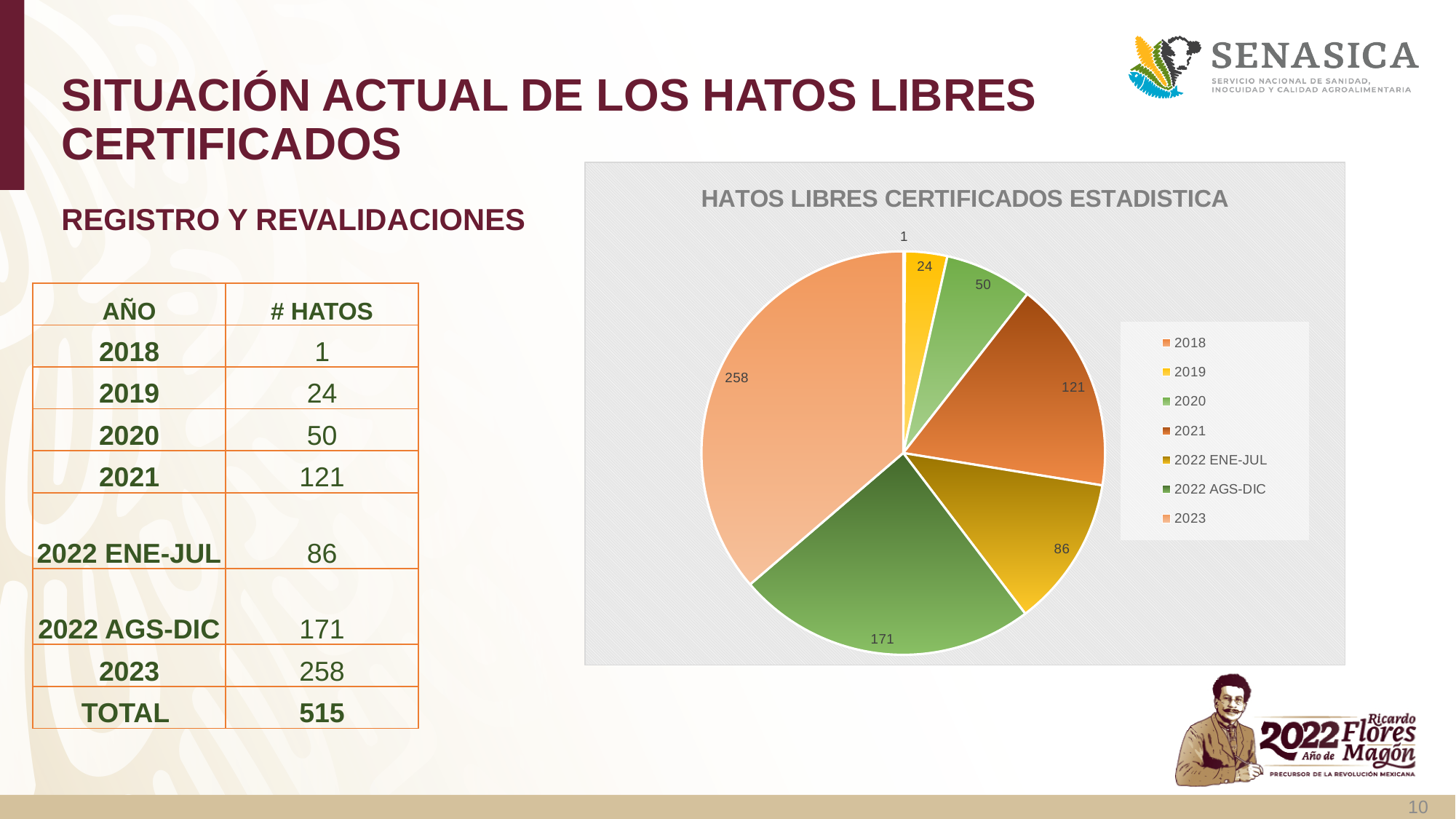
What is the value of the 2022 ENE-JUL slice in the pie chart? 86 Which category has the largest slice in the pie chart? 2023 Which legend entry is shown in dark green in the pie chart? 2022 AGS-DIC What is the value of the 2023 slice in the pie chart? 258 What type of chart is shown on the slide? pie chart How many slices does the pie chart have? 7 Which is larger in the pie chart, the 2020 slice or the 2019 slice? 2020 What is the title of the chart? HATOS LIBRES CERTIFICADOS ESTADISTICA What is the difference between the 2023 slice and the 2021 slice? 137 Which category has the smallest slice in the pie chart? 2018 What is the difference between the 2022 AGS-DIC slice and the 2022 ENE-JUL slice? 85 What is the value of the 2021 slice in the pie chart? 121